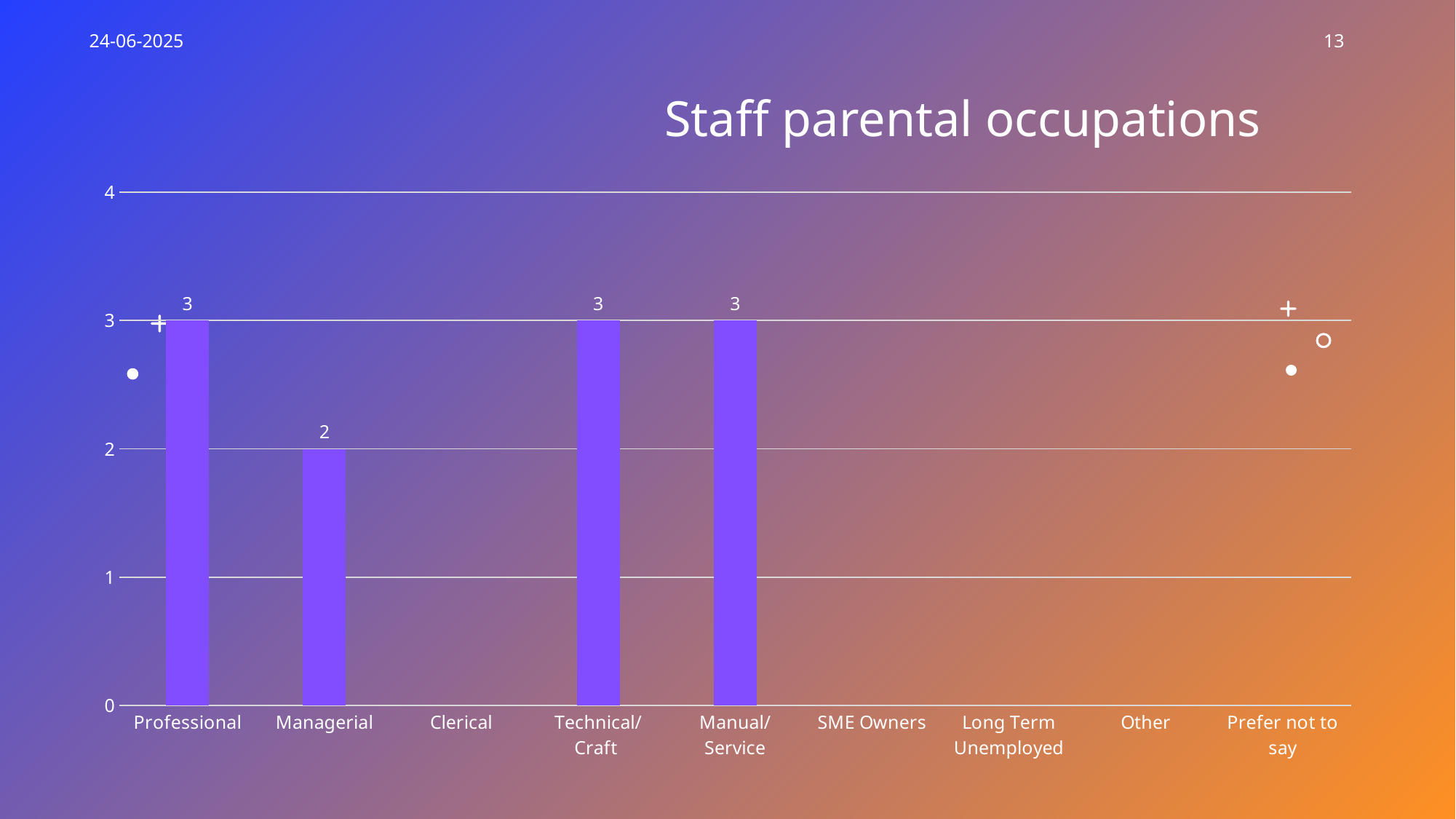
What is the value for Managerial? 2 How many categories have a visible bar? 4 Which category has the lowest value among those with a visible bar? Managerial How many categories are shown on the x axis? 9 What is the title of the chart? Staff parental occupations Which is larger, the value for Managerial or the value for Technical/Craft? Technical/Craft What is the difference between the values for Professional and Managerial? 1 What is the value for Technical/Craft? 3 What is the value for Professional? 3 What is the value for Manual/Service? 3 Is the value for Managerial greater or less than 3? less What kind of chart is shown on the slide? bar chart